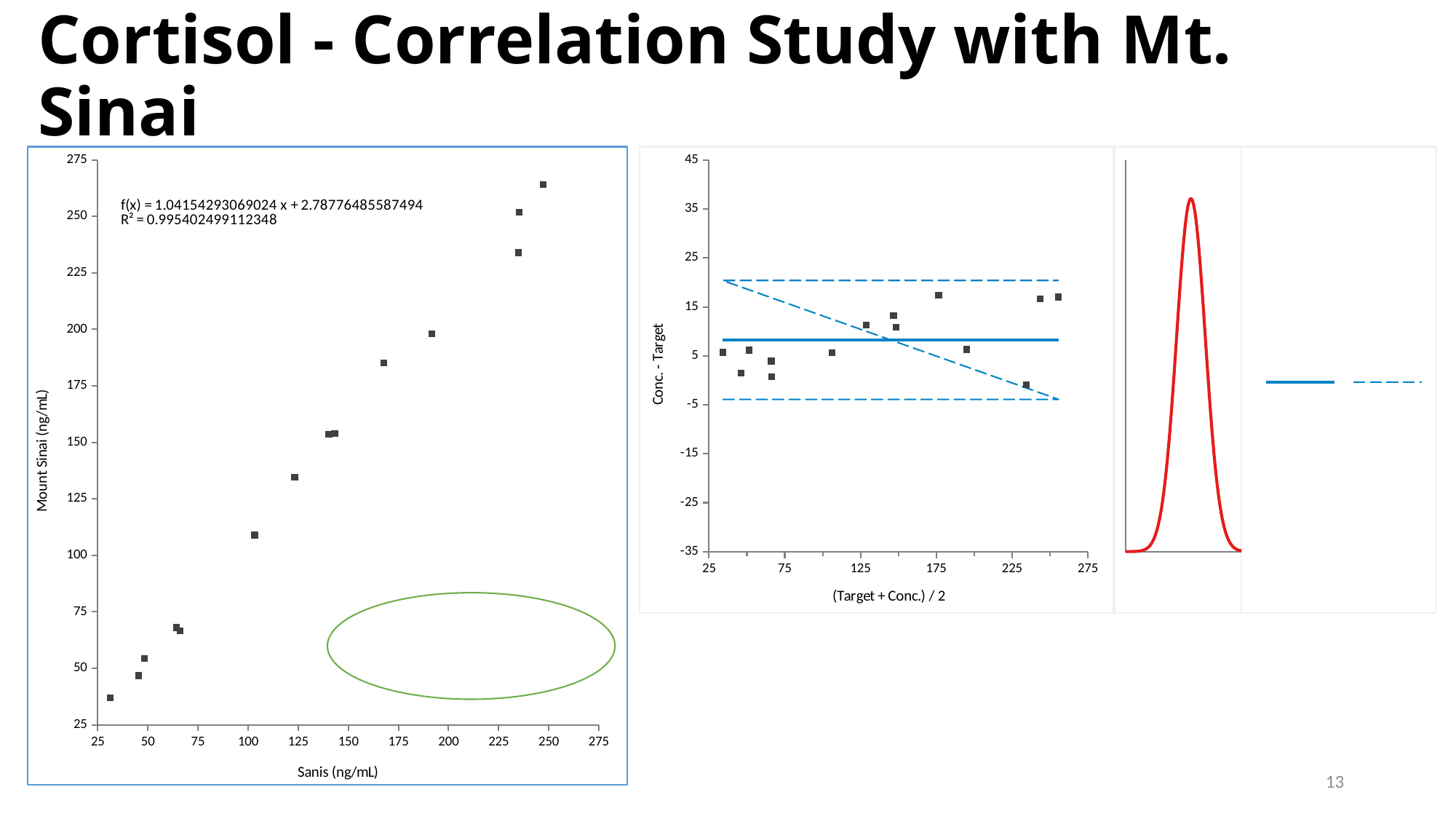
On the right chart, is the solid horizontal line greater or less than 5 on the Conc. - Target axis? greater On the left chart, what is the slope of the fitted line f(x)? 1.04154293069024 What kind of chart is the left chart plotting Sanis against Mount Sinai? Scatter chart On the left chart, is the Mount Sinai value of the highest point greater or less than 250? greater What is the y-axis label of the right chart? Conc. - Target On the right chart, is the upper dashed horizontal line greater or less than 15 on the Conc. - Target axis? greater On the left chart, do the Mount Sinai values rise or fall as the Sanis values increase along the x axis? Rise What is the x-axis label of the left chart? Sanis (ng/mL) On the left chart, what is the R² value printed for the trendline? 0.995402499112348 On the left chart, what is the intercept of the fitted line f(x)? 2.78776485587494